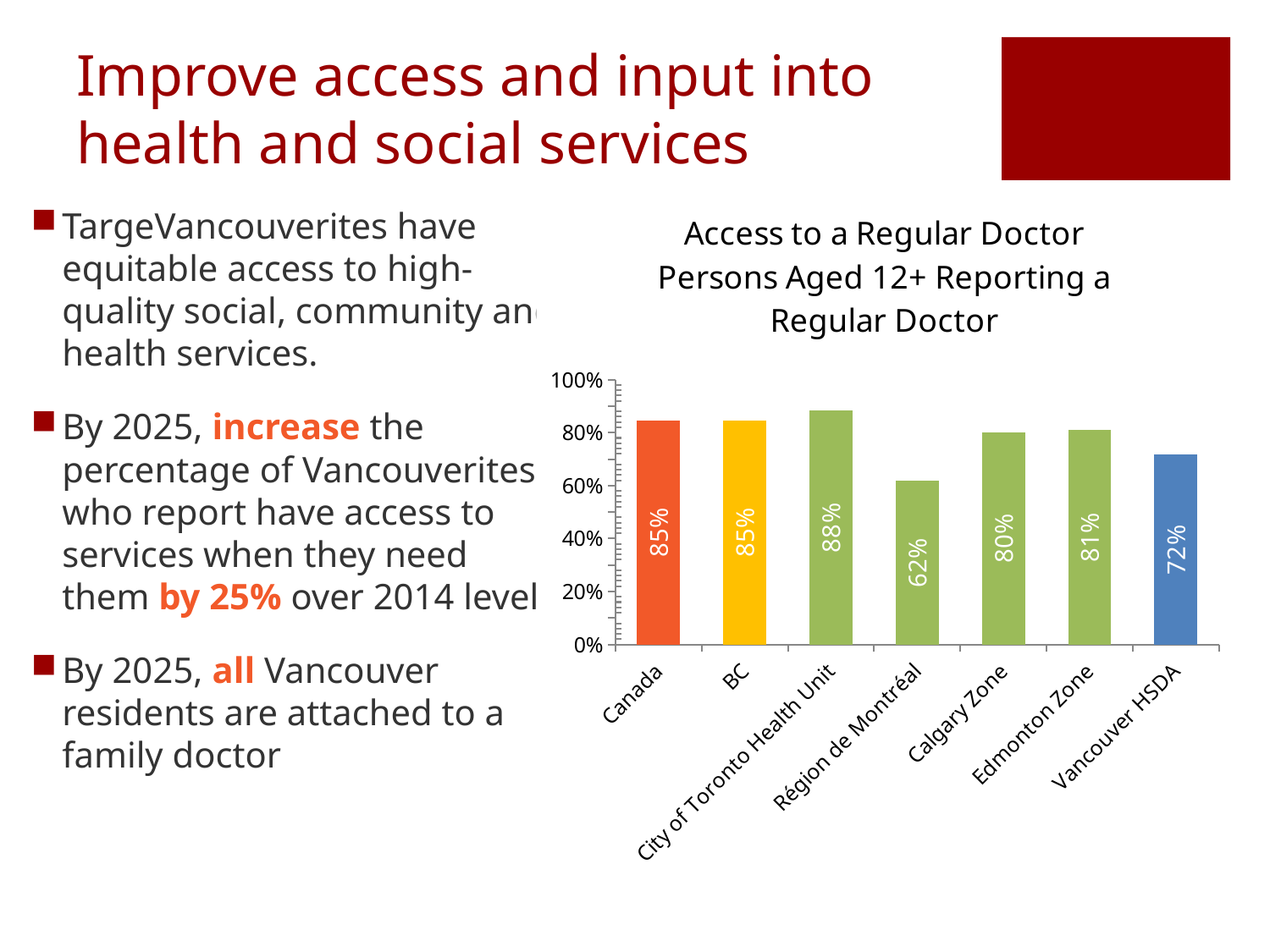
Which category has the lowest percentage reporting a regular doctor? Région de Montréal How many categories are shown on the x axis of the chart? 7 Which category has the highest percentage reporting a regular doctor? City of Toronto Health Unit What colour is the bar for BC? Yellow What is the title of the chart? Access to a Regular Doctor Persons Aged 12+ Reporting a Regular Doctor What kind of chart is shown on the slide? Bar chart Is the value for Vancouver HSDA greater or less than 80%? less What is the value shown for Région de Montréal? 62% What percentage of persons aged 12+ in Canada report having a regular doctor? 85% Which has a higher value, Calgary Zone or Edmonton Zone? Edmonton Zone What is the difference between the values for City of Toronto Health Unit and Vancouver HSDA? 16% What is the value shown for Vancouver HSDA? 72%